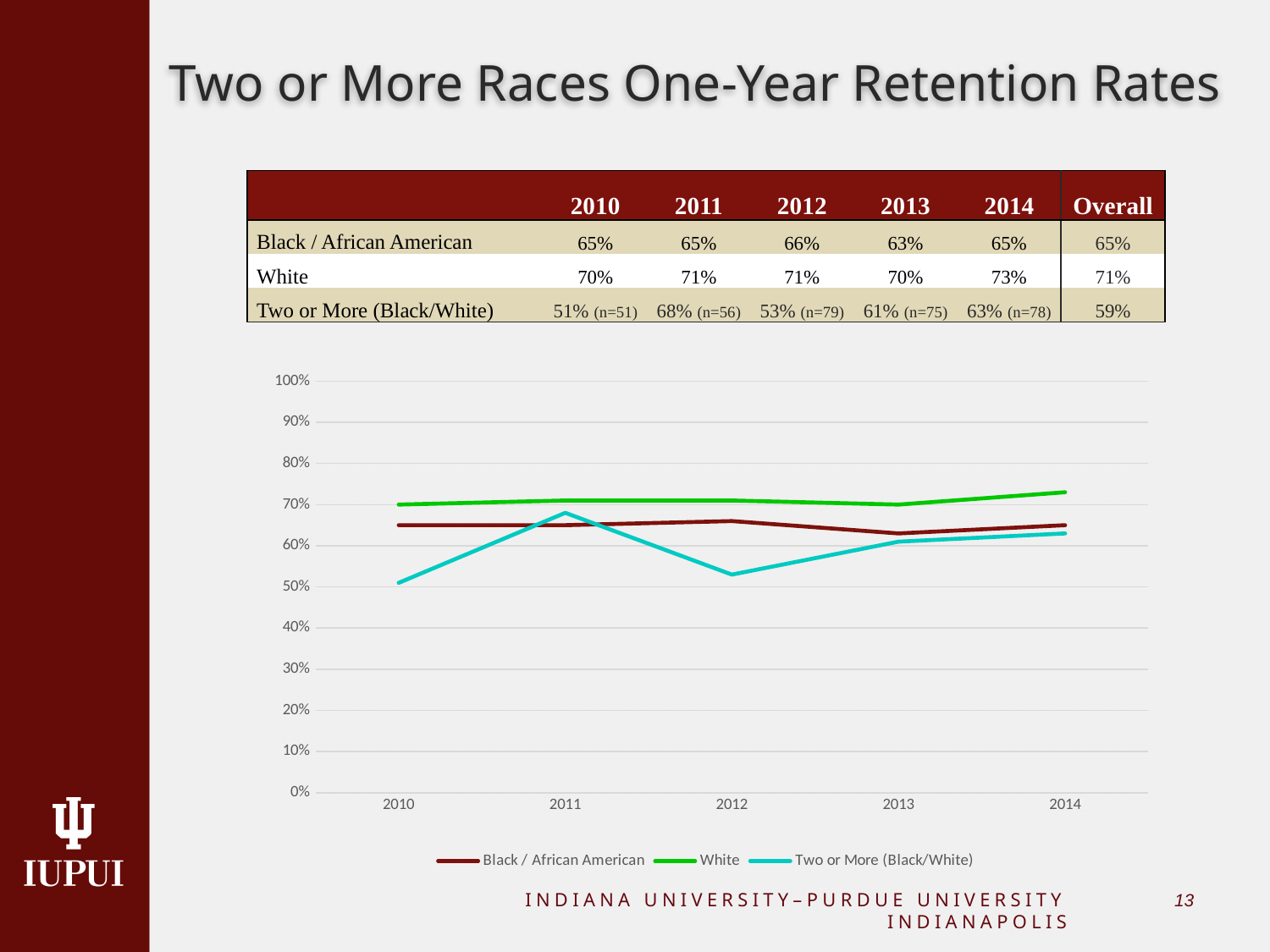
How many series does the chart legend list? 3 Is the Two or More (Black/White) retention rate in 2012 greater or less than 60%? less What is the difference between the White and Two or More (Black/White) retention rates in 2012? 18% What is the one-year retention rate for Two or More (Black/White) in 2010? 51% In which year is the Two or More (Black/White) retention rate highest? 2011 In which year is the Two or More (Black/White) retention rate lowest? 2010 Which series has the higher retention rate in 2011, Black / African American or Two or More (Black/White)? Two or More (Black/White) What is the one-year retention rate for White in 2014? 73% What is the one-year retention rate for Black / African American in 2013? 63% What kind of chart is shown on the slide? line chart Which series is shown with the green line in the chart? White How many years are plotted along the x axis of the chart? 5